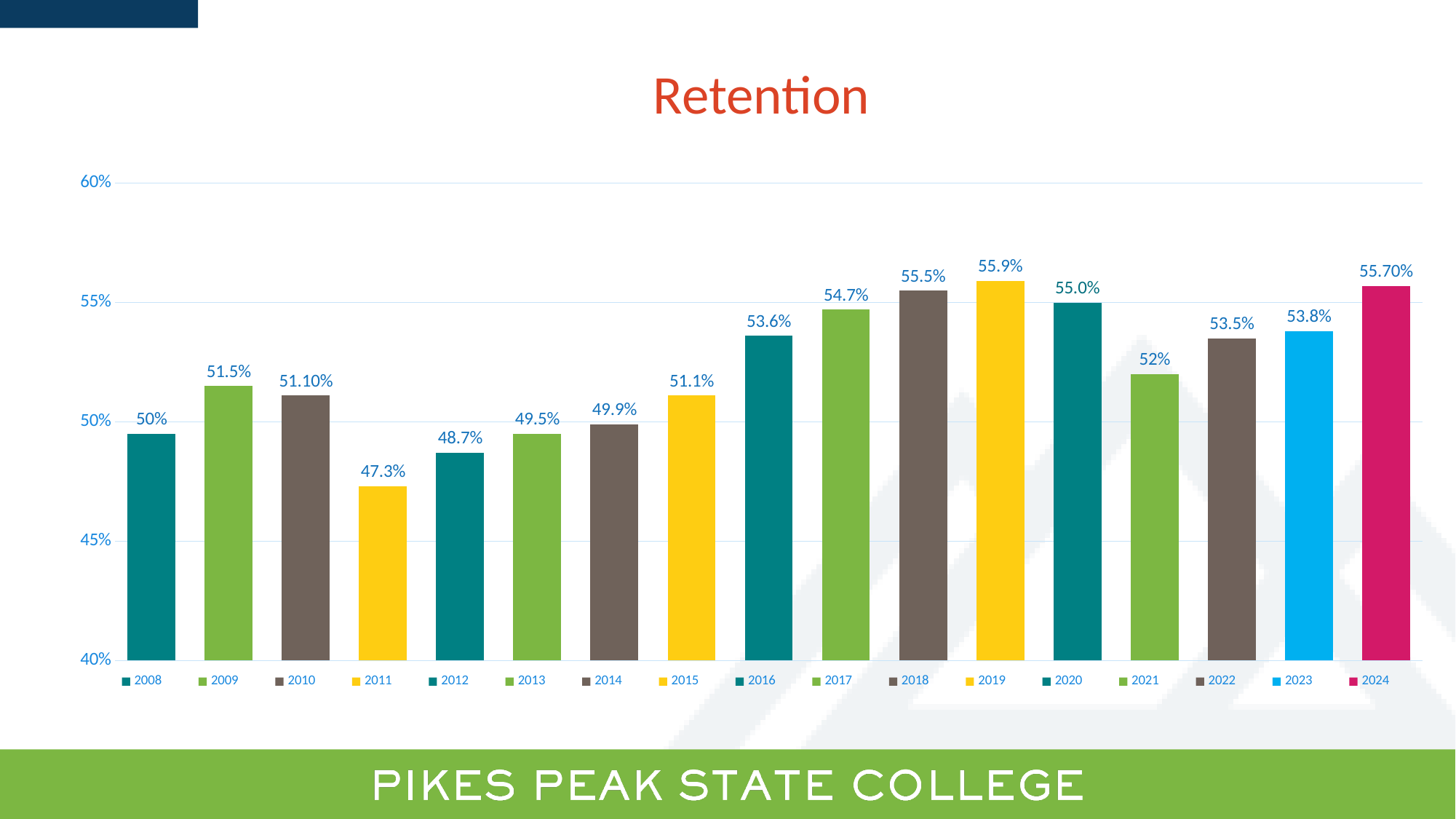
What is the retention value for 2016? 53.6% How many years are shown on the chart? 17 Which year has the highest retention value? 2019 Is the retention value for 2012 greater or less than 50%? less Which year has the lowest retention value? 2011 Which year has a larger retention value, 2018 or 2020? 2018 What is the title of the chart? Retention What is the difference between the retention values for 2019 and 2011? 8.6% What kind of chart is shown on the slide? bar chart How many entries does the legend list? 17 What is the retention value for 2011? 47.3% What is the retention value for 2024? 55.70%